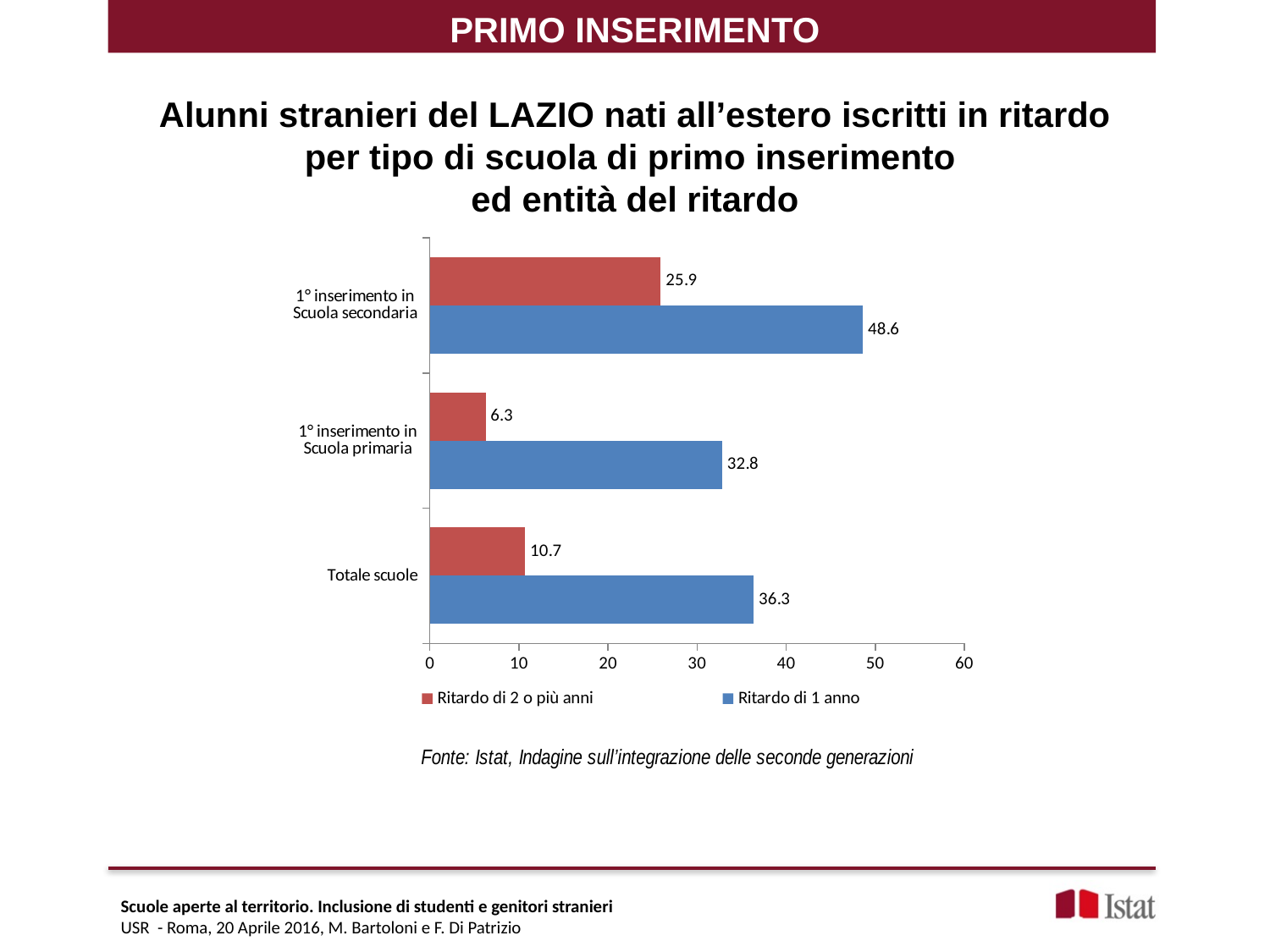
What kind of chart is shown on the slide? Bar chart How many series does the legend list? 2 Which category has the highest value for 'Ritardo di 1 anno'? 1° inserimento in Scuola secondaria Which category has the lowest value for 'Ritardo di 2 o più anni'? 1° inserimento in Scuola primaria What is the value of 'Ritardo di 1 anno' for 'Totale scuole'? 36.3 How many categories are shown on the y axis of the chart? 3 What is the value of 'Ritardo di 2 o più anni' for 'Totale scuole'? 10.7 Which is larger: 'Ritardo di 1 anno' for '1° inserimento in Scuola primaria' or 'Ritardo di 1 anno' for 'Totale scuole'? Totale scuole Which series is shown in blue in the chart? Ritardo di 1 anno What is the difference between 'Ritardo di 1 anno' and 'Ritardo di 2 o più anni' for '1° inserimento in Scuola secondaria'? 22.7 What is the value of 'Ritardo di 2 o più anni' for '1° inserimento in Scuola primaria'? 6.3 What is the value of 'Ritardo di 1 anno' for '1° inserimento in Scuola secondaria'? 48.6